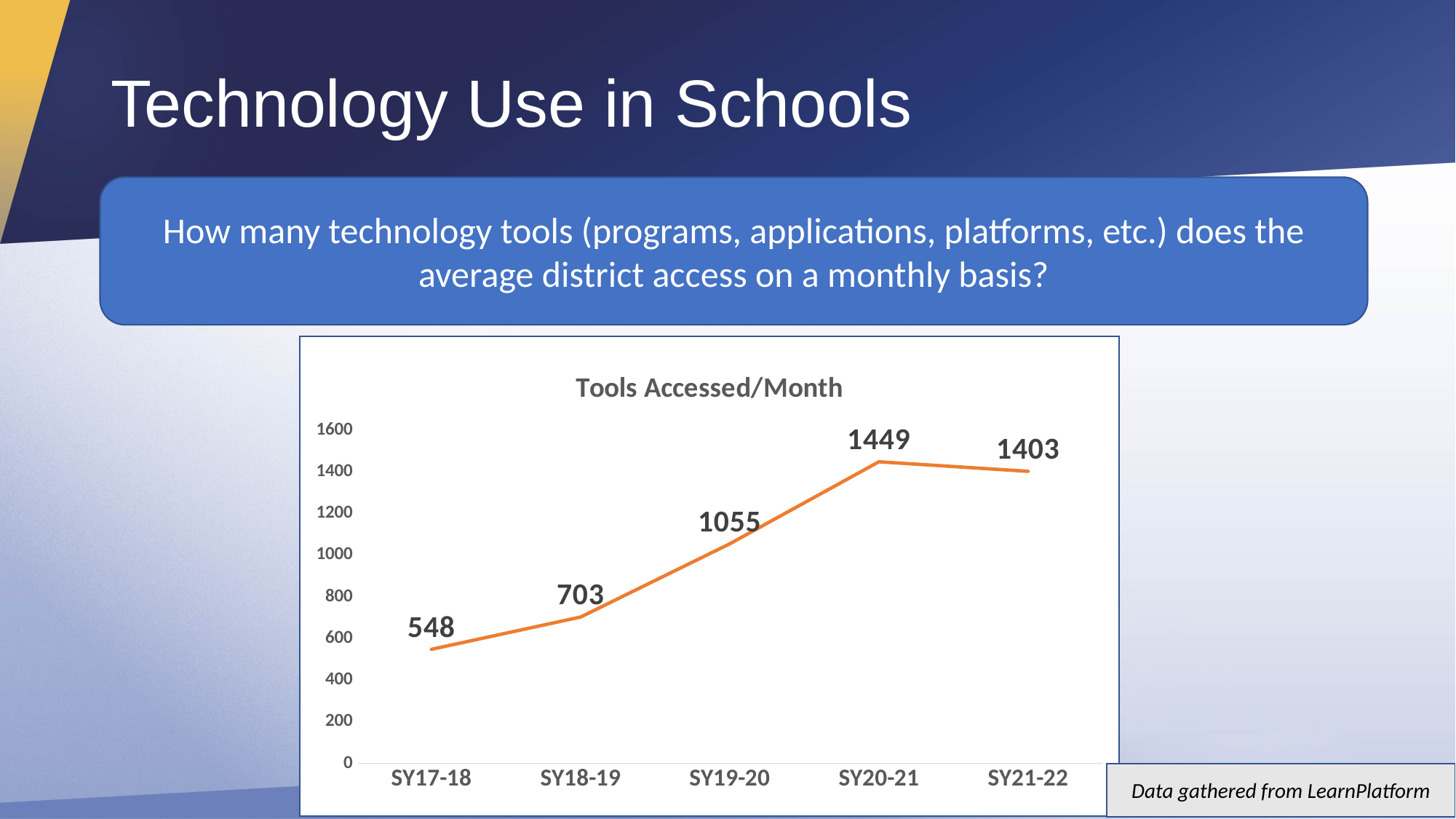
How many school years are plotted on the chart? 5 What is the difference between the values for SY20-21 and SY21-22? 46 Which is larger, the value for SY19-20 or the value for SY18-19? SY19-20 What is the value for SY21-22? 1403 What is the value for SY19-20? 1055 Do the values rise or fall from SY17-18 to SY20-21? Rise Which school year has the highest number of tools accessed per month? SY20-21 Which school year has the lowest number of tools accessed per month? SY17-18 What is the title of the chart? Tools Accessed/Month What kind of chart is shown on the slide? Line chart What is the difference between the values for SY18-19 and SY17-18? 155 What is the value for SY17-18? 548